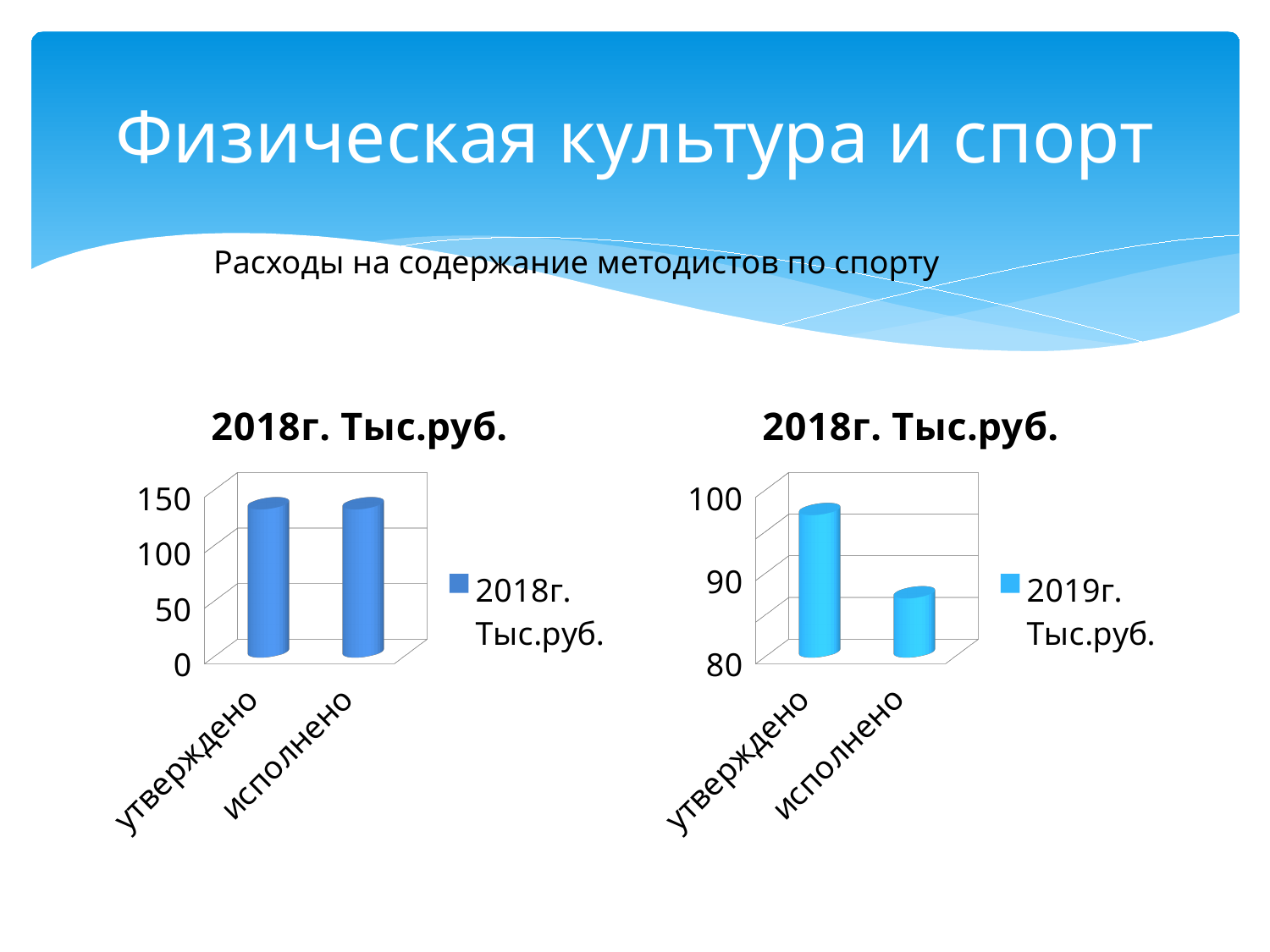
In the right chart, is the value for утверждено greater or less than 90? greater What kind of chart is the left chart on the slide? bar chart In the left chart, is the value for исполнено greater or less than 150? less In the right chart, which category has the highest value? утверждено In the right chart, do the values rise or fall from утверждено to исполнено? fall In the left chart, is the value for утверждено greater or less than 100? greater In the right chart, which is larger: утверждено or исполнено? утверждено How many series does the legend of the left chart list? 1 How many categories does the right chart show? 2 What series name does the legend of the right chart show? 2019г. Тыс.руб. In the right chart, which category has the lowest value? исполнено